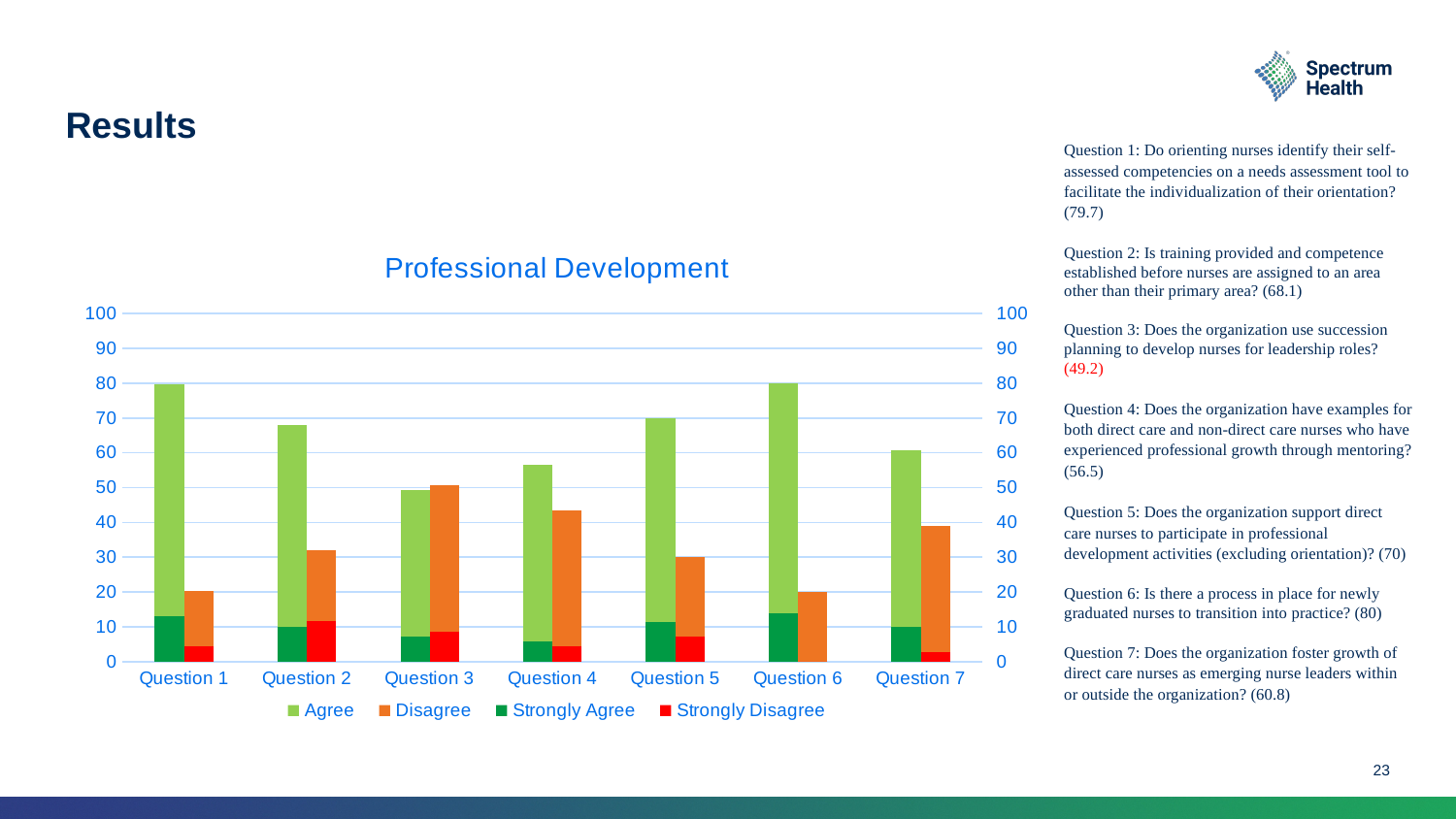
Which question has the highest Disagree value? Question 3 For Question 4, which is larger, the Agree value or the Disagree value? Agree Is the Disagree value for Question 5 greater or less than 40? less Which question has the lowest Agree value? Question 3 How many series does the chart's legend list? 4 How many questions (categories) are shown on the x axis of the chart? 7 Which colour represents the Strongly Disagree series in the chart? Red What kind of chart is shown on the slide? Bar chart What is the title of the chart? Professional Development Which question has the lowest Strongly Disagree value? Question 6 Is the Agree value for Question 4 greater or less than 50? greater Is the Agree value for Question 1 greater or less than 70? greater